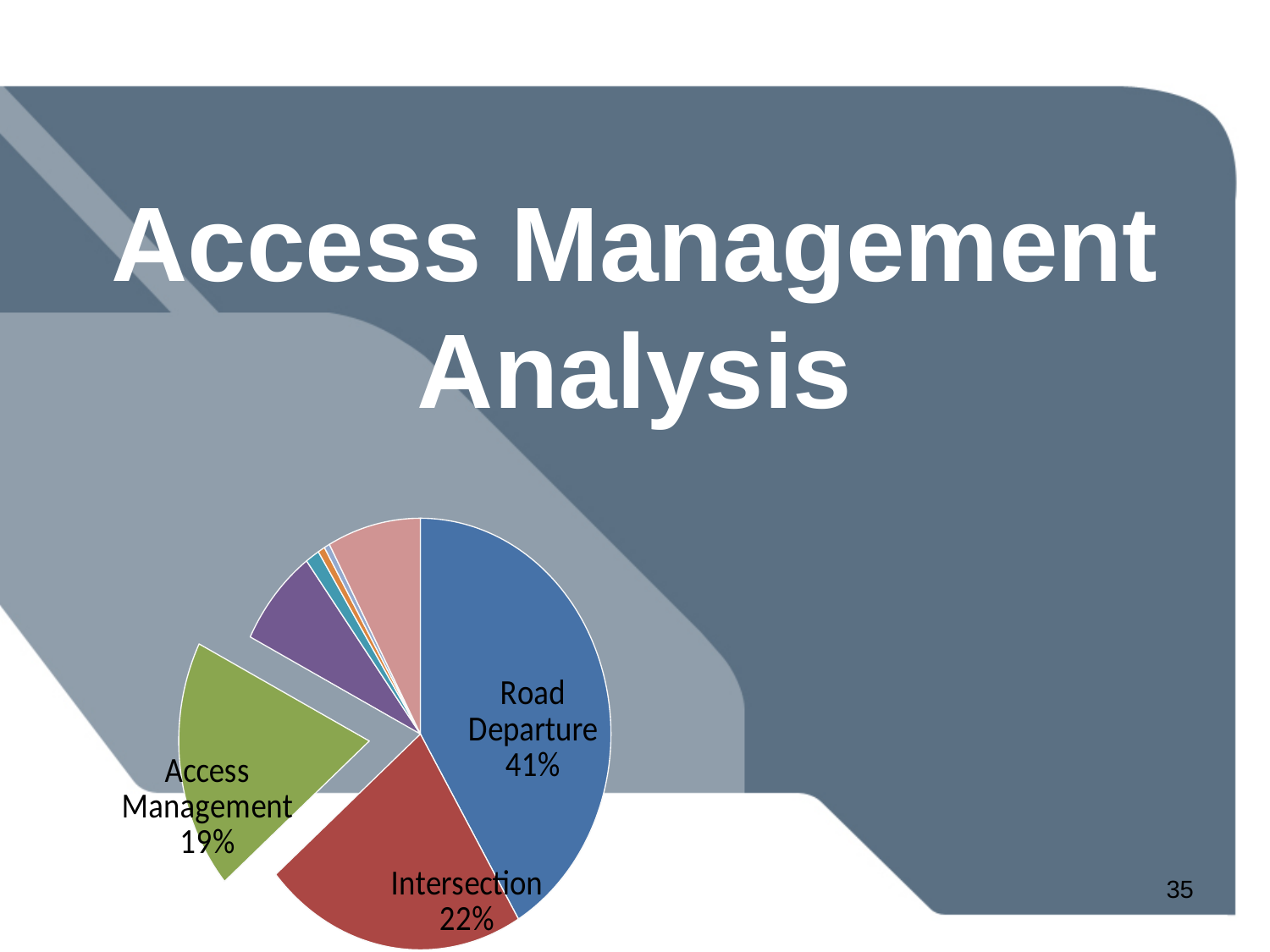
Which is larger, Road Departure or Intersection? Road Departure Among the labeled slices, which has the smallest share? Access Management How many percentage points larger is Road Departure than Intersection? 19 What is the difference in percentage points between Intersection and Access Management? 3 What percentage is shown for the Access Management slice? 19% Which is larger, the Intersection slice or the Access Management slice? Intersection Which slice is pulled out (exploded) from the rest of the pie? Access Management Which slice of the pie chart is the largest? Road Departure What percentage of the pie chart is Road Departure? 41% What is the combined share of the Road Departure, Intersection and Access Management slices? 82% What share of the pie chart does Intersection account for? 22% What type of chart is shown on the slide? Pie chart